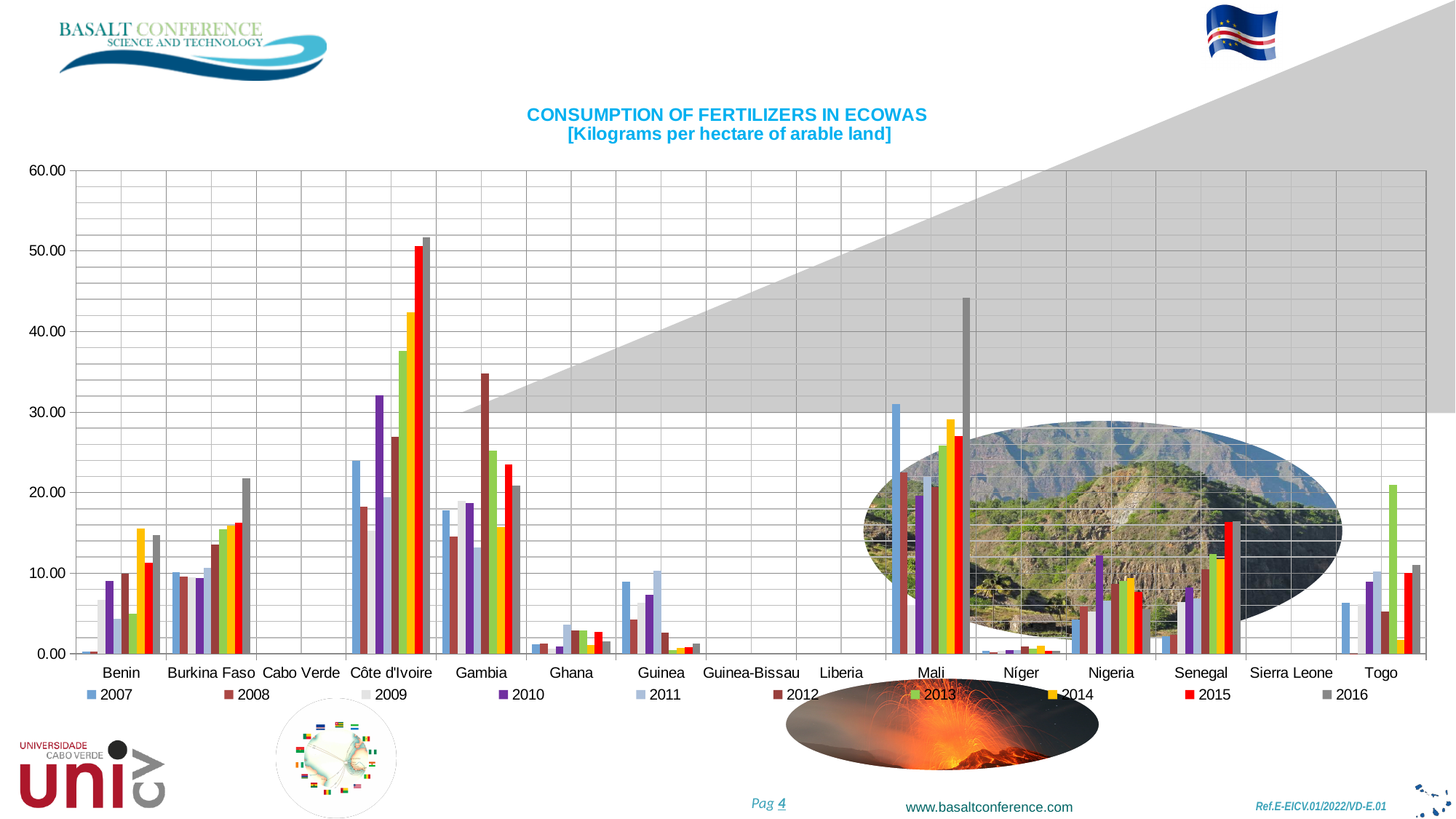
Is the value for Benin in 2014 greater or less than 10? greater Which colour represents the 2015 series in the legend? red What kind of chart is shown on the slide? bar chart What is the title of the chart? CONSUMPTION OF FERTILIZERS IN ECOWAS [Kilograms per hectare of arable land] Is the value for Ghana in 2011 greater or less than 10? less Is the value for Mali in 2016 greater or less than 40? greater How many countries are shown on the x axis? 15 Which country has the tallest bar in the chart? Côte d'Ivoire Do the values for Côte d'Ivoire rise or fall from 2012 to 2016? rise How many series does the legend list? 10 Which is larger: the value for Côte d'Ivoire in 2015 or the value for Mali in 2016? Côte d'Ivoire in 2015